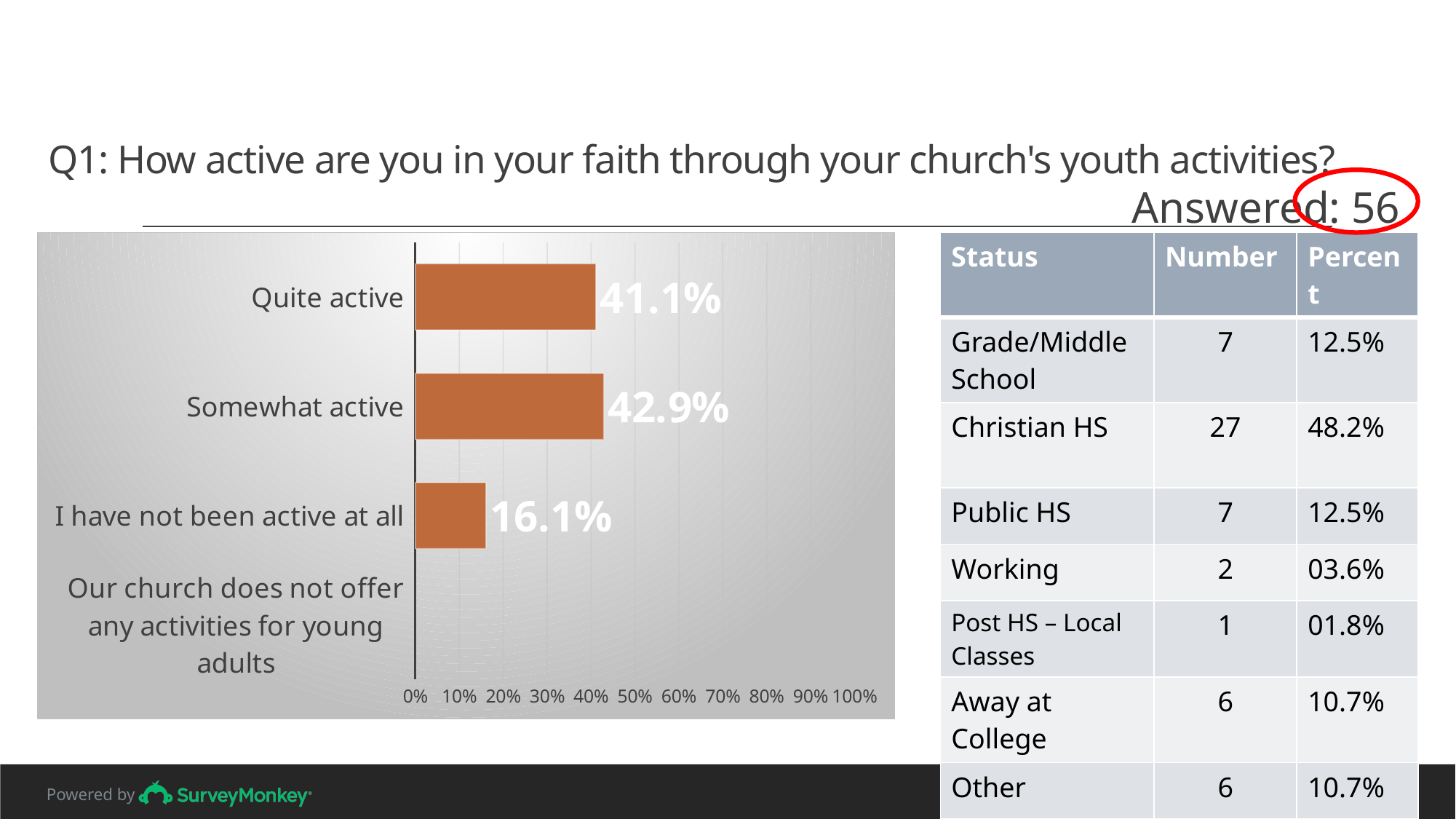
What is the highest value shown on the chart's horizontal axis? 100% Is the value for "Somewhat active" greater or less than 50%? less Which is larger: the value for "Quite active" or for "I have not been active at all"? Quite active What is the difference in percentage points between "Somewhat active" and "Quite active"? 1.8 What is the difference in percentage points between "Quite active" and "I have not been active at all"? 25.0 What percentage is shown for "I have not been active at all"? 16.1% What kind of chart is shown on the slide? bar chart Which category has the highest value in the bar chart? Somewhat active How many categories are listed on the bar chart's vertical axis? 4 What value is shown for "Somewhat active"? 42.9% What percentage of respondents said they are "Quite active"? 41.1%